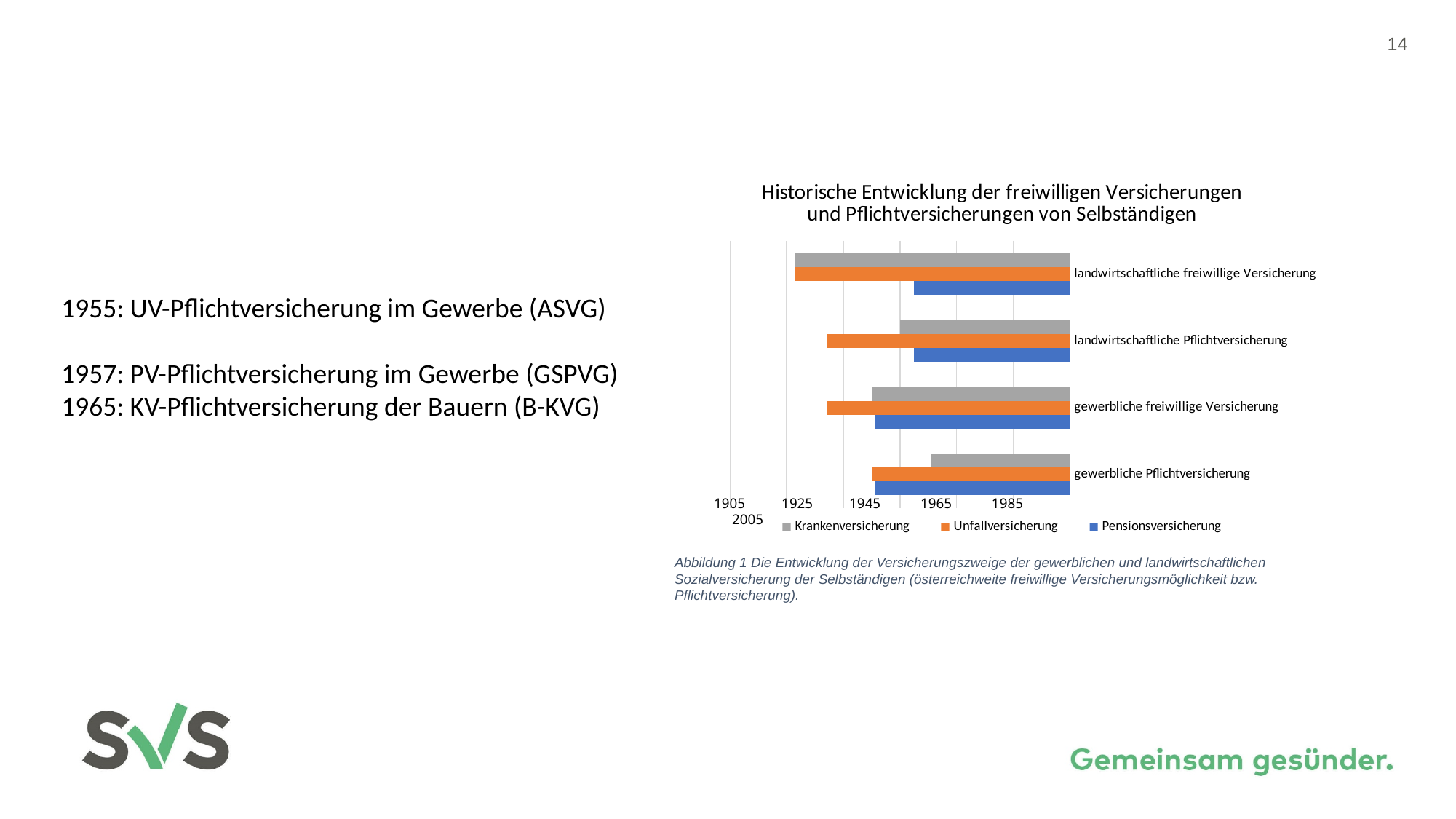
Does the Pensionsversicherung bar for landwirtschaftliche Pflichtversicherung begin before or after 1945? after What kind of chart is shown on the slide? bar chart Which series is shown in orange in the chart? Unfallversicherung Does the Unfallversicherung bar for landwirtschaftliche Pflichtversicherung begin before or after 1945? before How many series does the chart legend list? 3 For gewerbliche Pflichtversicherung, which bar begins later: Krankenversicherung or Unfallversicherung? Krankenversicherung Does the Krankenversicherung bar for landwirtschaftliche freiwillige Versicherung begin before or after 1945? before What is the title of the chart? Historische Entwicklung der freiwilligen Versicherungen und Pflichtversicherungen von Selbständigen How many categories are shown on the vertical axis of the chart? 4 Which category has the earliest-starting Krankenversicherung bar? landwirtschaftliche freiwillige Versicherung For landwirtschaftliche Pflichtversicherung, which bar begins earlier: Unfallversicherung or Krankenversicherung? Unfallversicherung